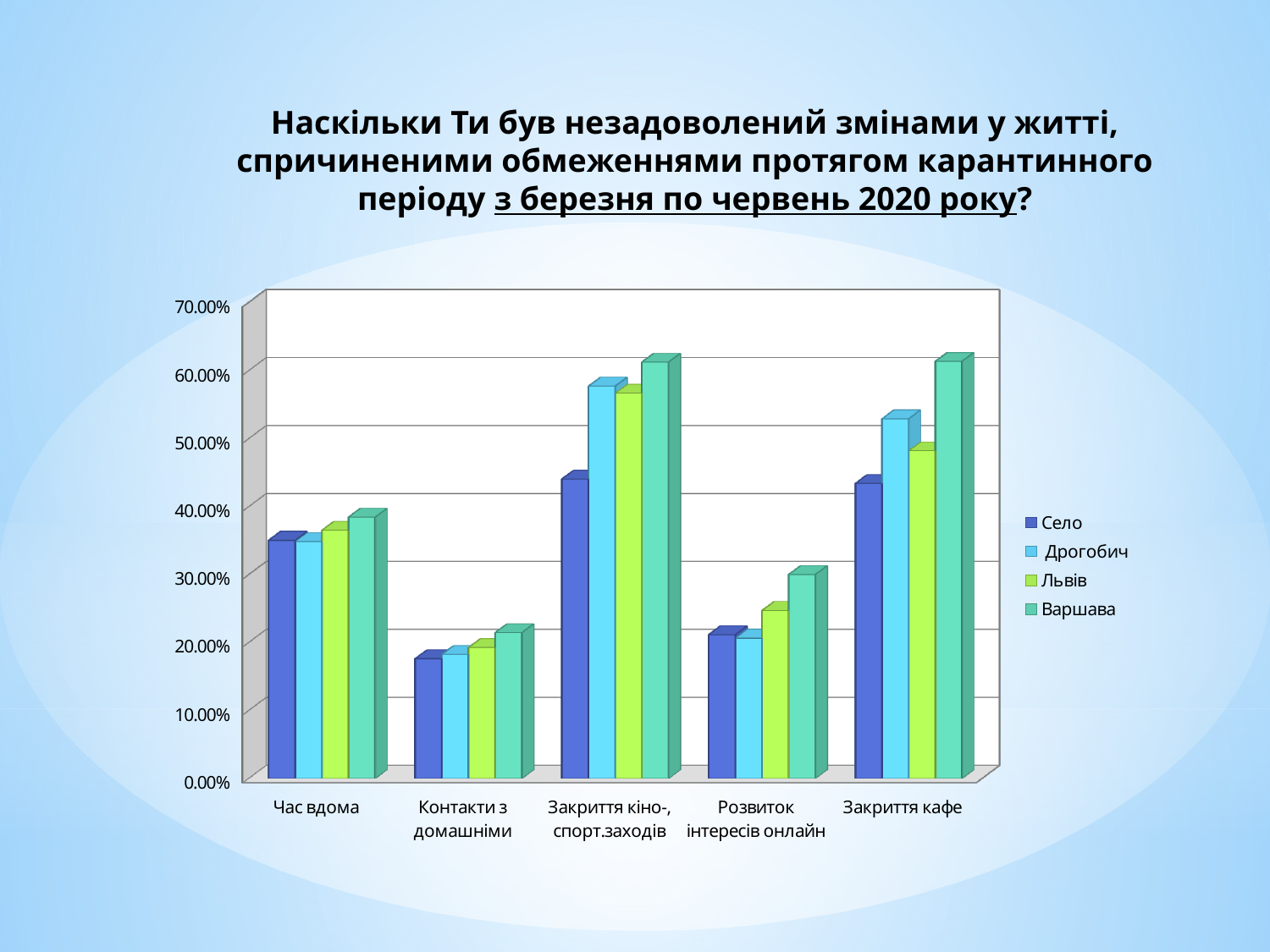
Which series does the legend list last? Варшава Is the value for Варшава in the category Розвиток інтересів онлайн greater or less than 40.00%? less Is the value for Варшава in the category Закриття кіно-, спорт.заходів greater or less than 50.00%? greater What kind of chart is shown on the slide? bar chart In the category Розвиток інтересів онлайн, which is larger: the value for Львів or the value for Варшава? Варшава Is the value for Дрогобич in the category Закриття кафе greater or less than 50.00%? greater How many categories are shown along the x axis? 5 Which series has the lowest value in the category Закриття кіно-, спорт.заходів? Село For the series Село, which category has the lowest value? Контакти з домашніми How many series does the legend list? 4 Which series has the highest value in the category Закриття кафе? Варшава